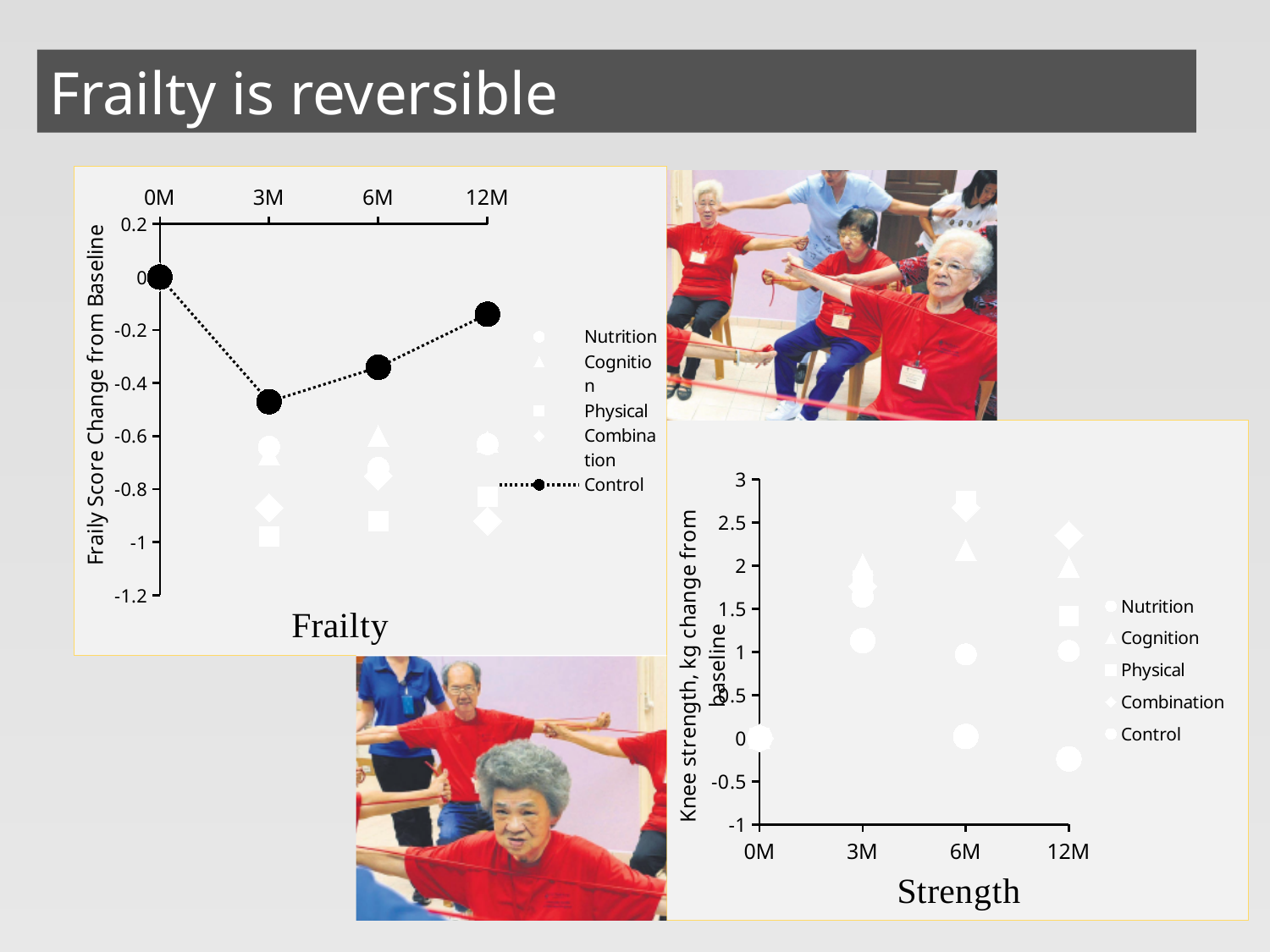
What is the y-axis title of the Strength chart? Knee strength, kg change from baseline In the Frailty chart, does the Control line rise or fall from 3M to 12M? rise How many time points are shown on the x axis of the Strength chart? 4 In the Frailty chart, what is the value for Control at 0M? 0 In the Frailty chart, is the value for Control at 12M greater or less than -0.2? greater In the Frailty chart, is the value for Control at 3M greater or less than -0.4? less In the Frailty chart, at 12M, which is higher: Control or Nutrition? Control In the Strength chart, is the value for Combination at 6M greater or less than 2.5? greater In the Strength chart, at 6M, which is larger: Combination or Control? Combination How many series does the legend of the Strength chart list? 5 In the Strength chart, which series has the highest value at 12M? Combination